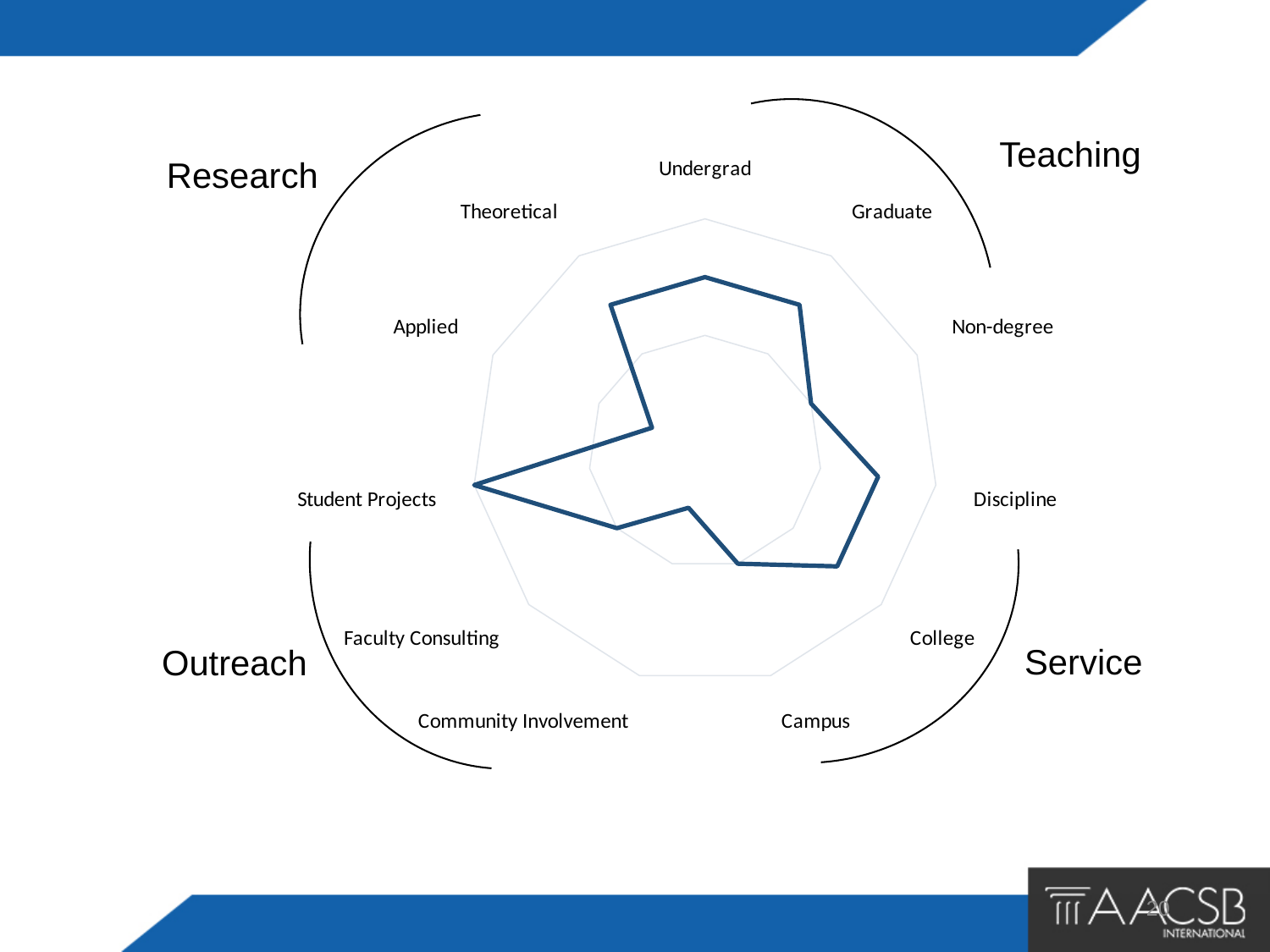
Which has the larger value, Student Projects or Discipline? Student Projects Which category has the highest value on the radar chart? Student Projects Which categories on the radar chart fall under the Teaching group? Undergrad, Graduate, Non-degree How many categories are plotted around the radar chart? 11 Which has the larger value, Graduate or Applied? Graduate Which has the larger value, Discipline or Non-degree? Discipline What are the four group labels placed around the outside of the radar chart? Research, Teaching, Service, Outreach What kind of chart is shown on the slide? Radar chart